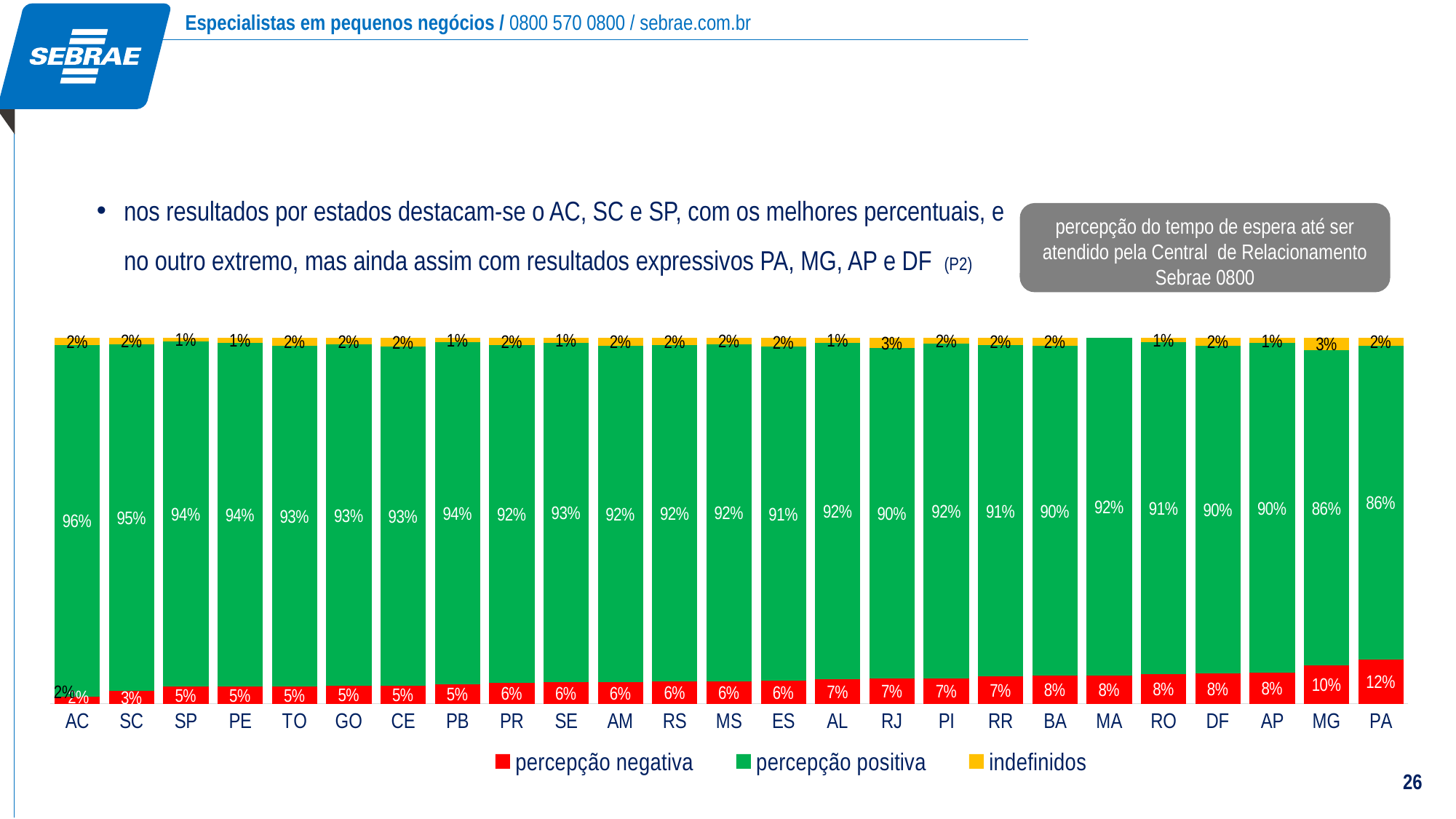
Which is larger, the 'percepção positiva' value for SC or for PA? SC Which state has the lowest 'percepção negativa' value? AC Which state has the highest 'percepção negativa' value? PA What is the difference between the 'percepção negativa' values for PA and AC? 10 percentage points How many series does the legend list? 3 What is the 'indefinidos' value for RJ? 3% How many states are shown on the x axis of the chart? 25 What is the 'percepção positiva' value for AC? 96% What is the 'percepção negativa' value for MG? 10% What is the 'percepção negativa' value for PA? 12% Which state has the highest 'percepção positiva' value? AC What kind of chart is shown on the slide? Stacked bar chart